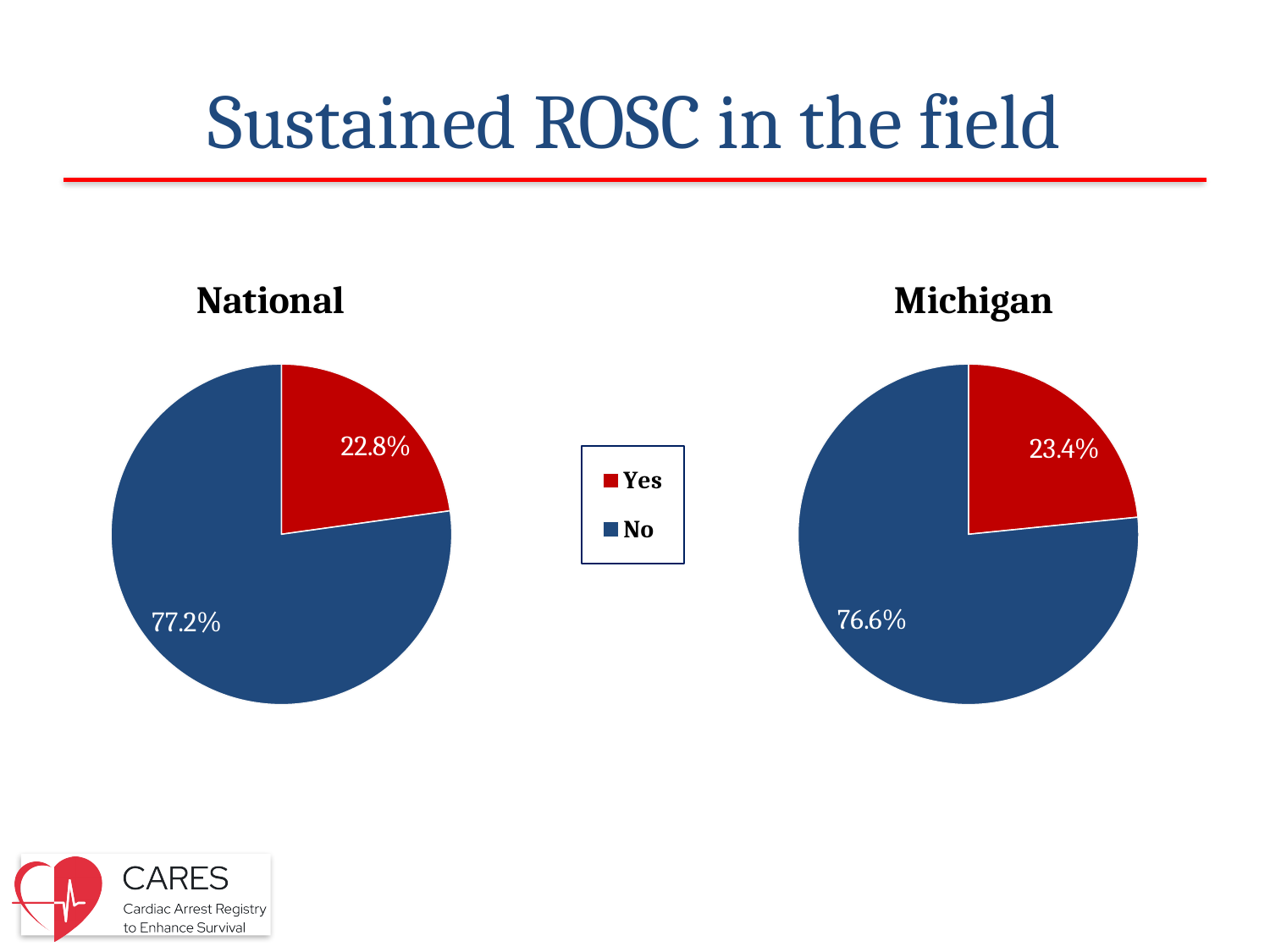
What is the difference between the No and Yes percentages in the National pie chart? 54.4% In the National pie chart, what percentage is shown for No? 77.2% In the National pie chart, what percentage is shown for Yes? 22.8% In the Michigan pie chart, what percentage is shown for No? 76.6% In the Michigan pie chart, which slice is the largest? No In the Michigan pie chart, what percentage is shown for Yes? 23.4% Which is larger: the Yes share in the National chart or the Yes share in the Michigan chart? Michigan What type of chart is used for the National data? Pie chart In the National pie chart, which slice is the smallest? Yes What colour represents Yes in the legend? Red How many entries does the legend list? 2 How many slices does the Michigan pie chart have? 2